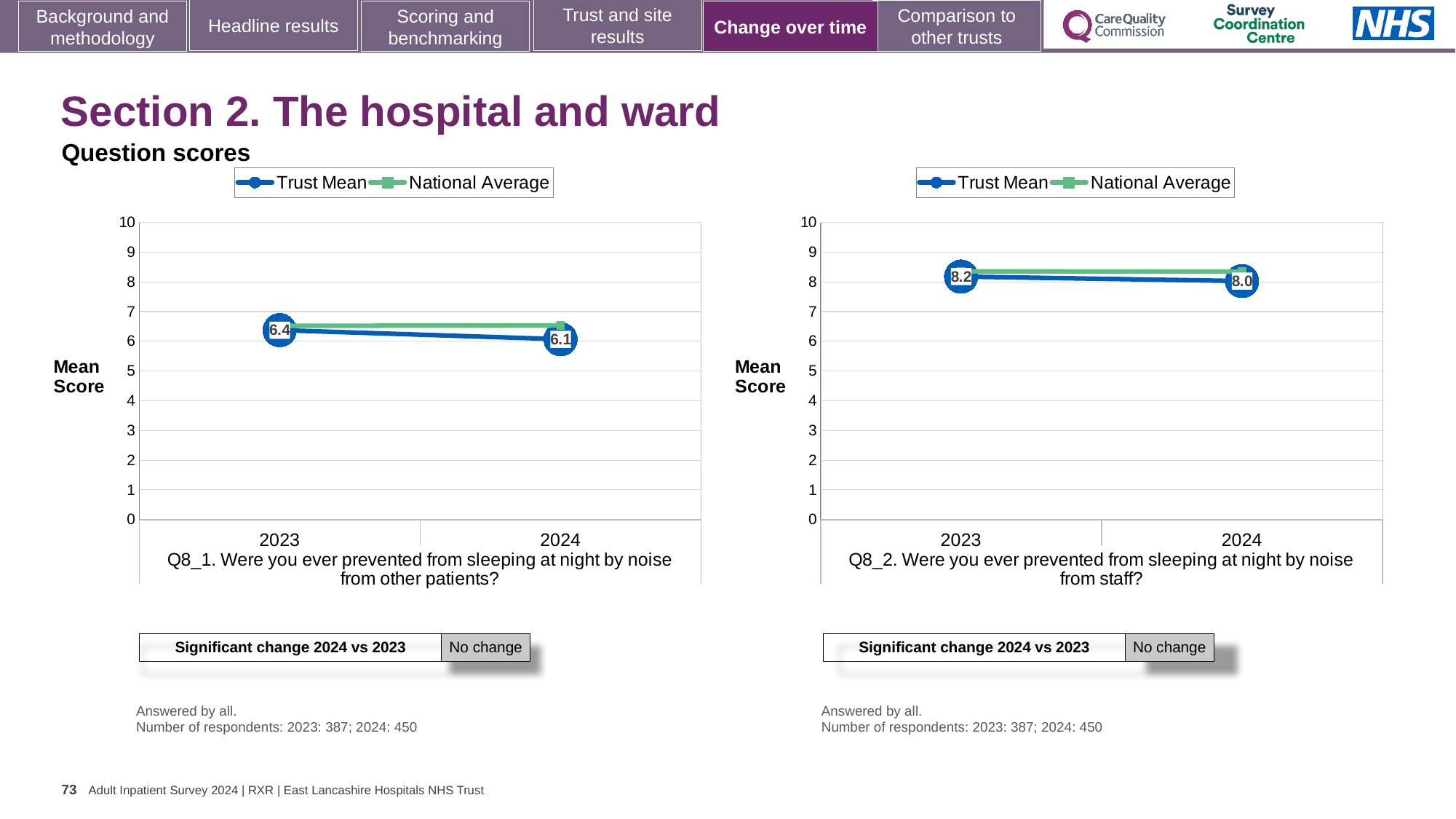
In the right chart (Q8_2), which year has the higher Trust Mean score, 2023 or 2024? 2023 In the left chart (Q8_1, noise from other patients), what is the Trust Mean score for 2024? 6.1 In the right chart (Q8_2), is the National Average value for 2024 greater or less than 7? greater How many series does the legend of the right chart (Q8_2) list? 2 In the right chart (Q8_2, noise from staff), what is the Trust Mean score for 2023? 8.2 In the right chart (Q8_2, noise from staff), what is the Trust Mean score for 2024? 8.0 What kind of chart is the left chart (Q8_1)? line chart In the left chart (Q8_1), by how much did the Trust Mean score change from 2023 to 2024? 0.3 In the left chart (Q8_1, noise from other patients), what is the Trust Mean score for 2023? 6.4 In the right chart (Q8_2), what is the difference between the Trust Mean scores for 2023 and 2024? 0.2 How many years are plotted on the x axis of the left chart (Q8_1)? 2 In the left chart (Q8_1), does the Trust Mean rise or fall from 2023 to 2024? fall